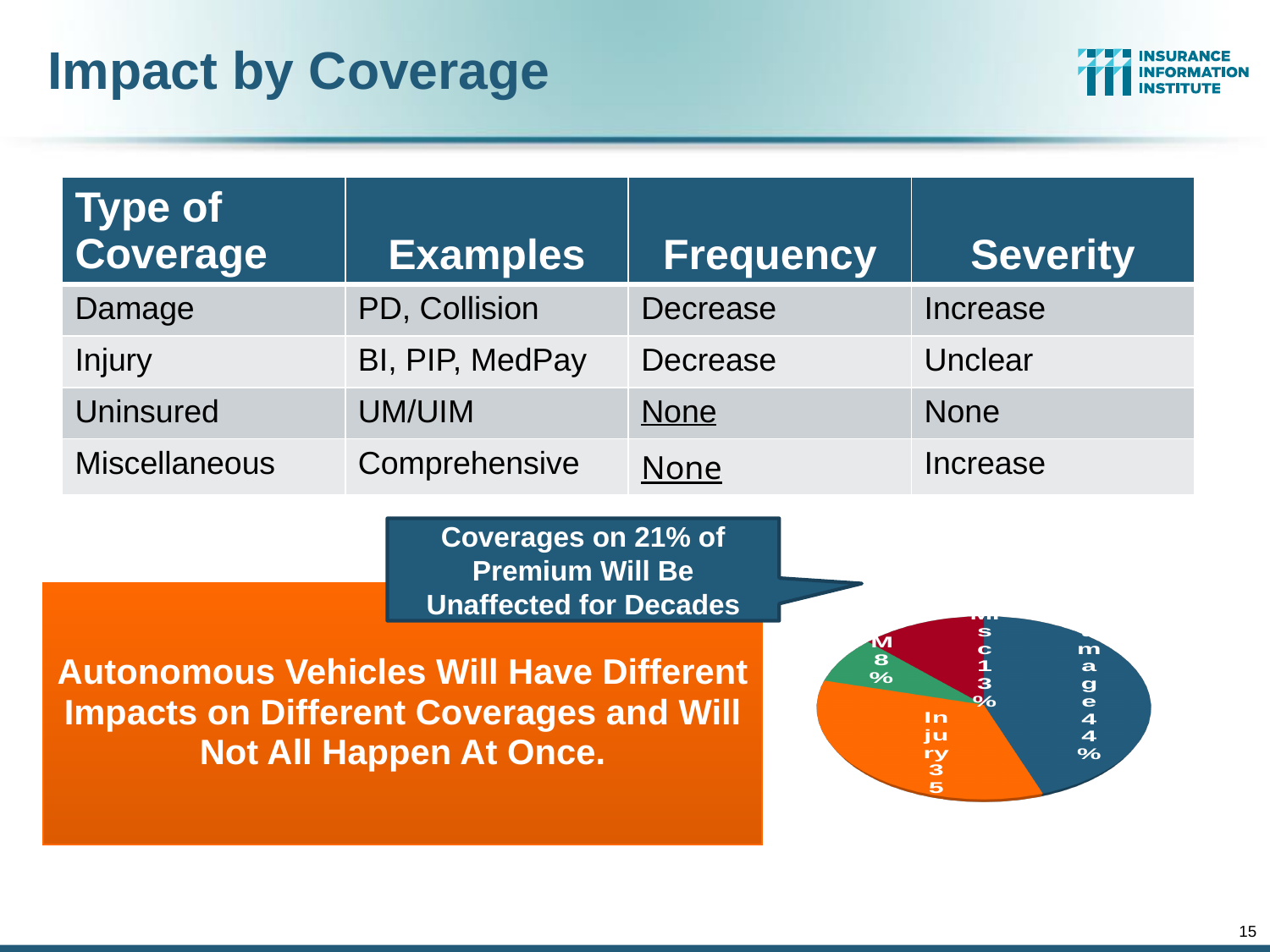
By how many percentage points does the Damage slice exceed the Misc slice in the pie chart? 31% How many slices does the pie chart have? 4 What percentage does the pie chart show for UM? 8% What percentage does the pie chart show for Damage? 44% What kind of chart is shown at the bottom right of the slide? pie chart In the pie chart, which is larger, the Damage slice or the Injury slice? Damage Which slice of the pie chart is the smallest? UM What colour is the Damage slice in the pie chart? dark blue Which slice of the pie chart is the largest? Damage By how many percentage points does the Misc slice exceed the UM slice in the pie chart? 5% What percentage does the pie chart show for Misc? 13% In the pie chart, which is larger, the Misc slice or the UM slice? Misc